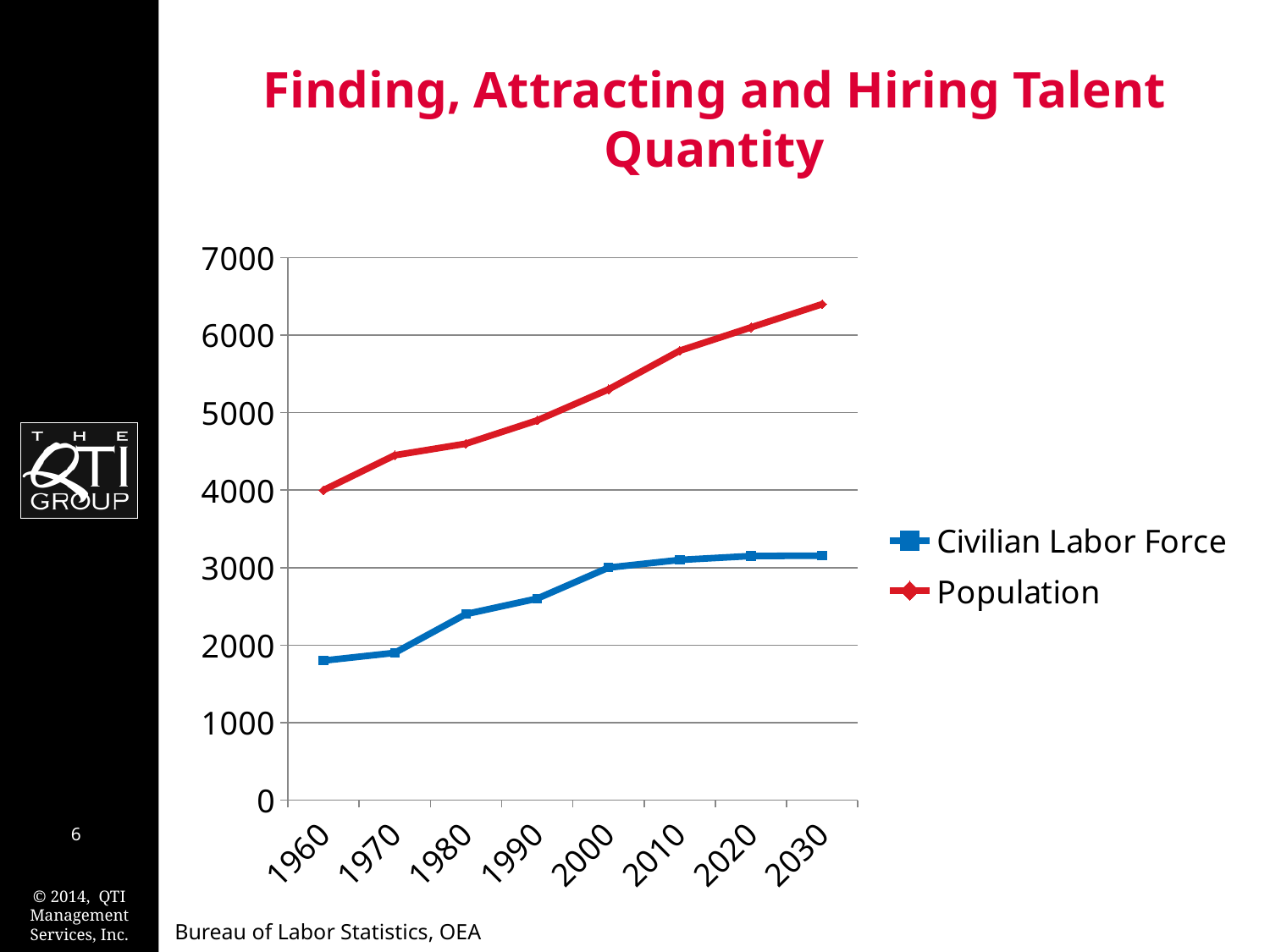
Is the Population value for 2030 greater or less than 6000? greater In 2000, which is larger, Population or Civilian Labor Force? Population Is the Civilian Labor Force value for 1960 greater or less than 2000? less Does the Population series rise or fall from 1960 to 2030? rise What kind of chart is shown on the slide? line chart Is the Population value for 2010 greater or less than 5000? greater In which year is the Population series at its highest? 2030 How many series does the legend list? 2 Which series is shown in red in the legend? Population In which year is the Civilian Labor Force series at its lowest? 1960 How many years are plotted along the x axis? 8 What source is cited below the chart? Bureau of Labor Statistics, OEA